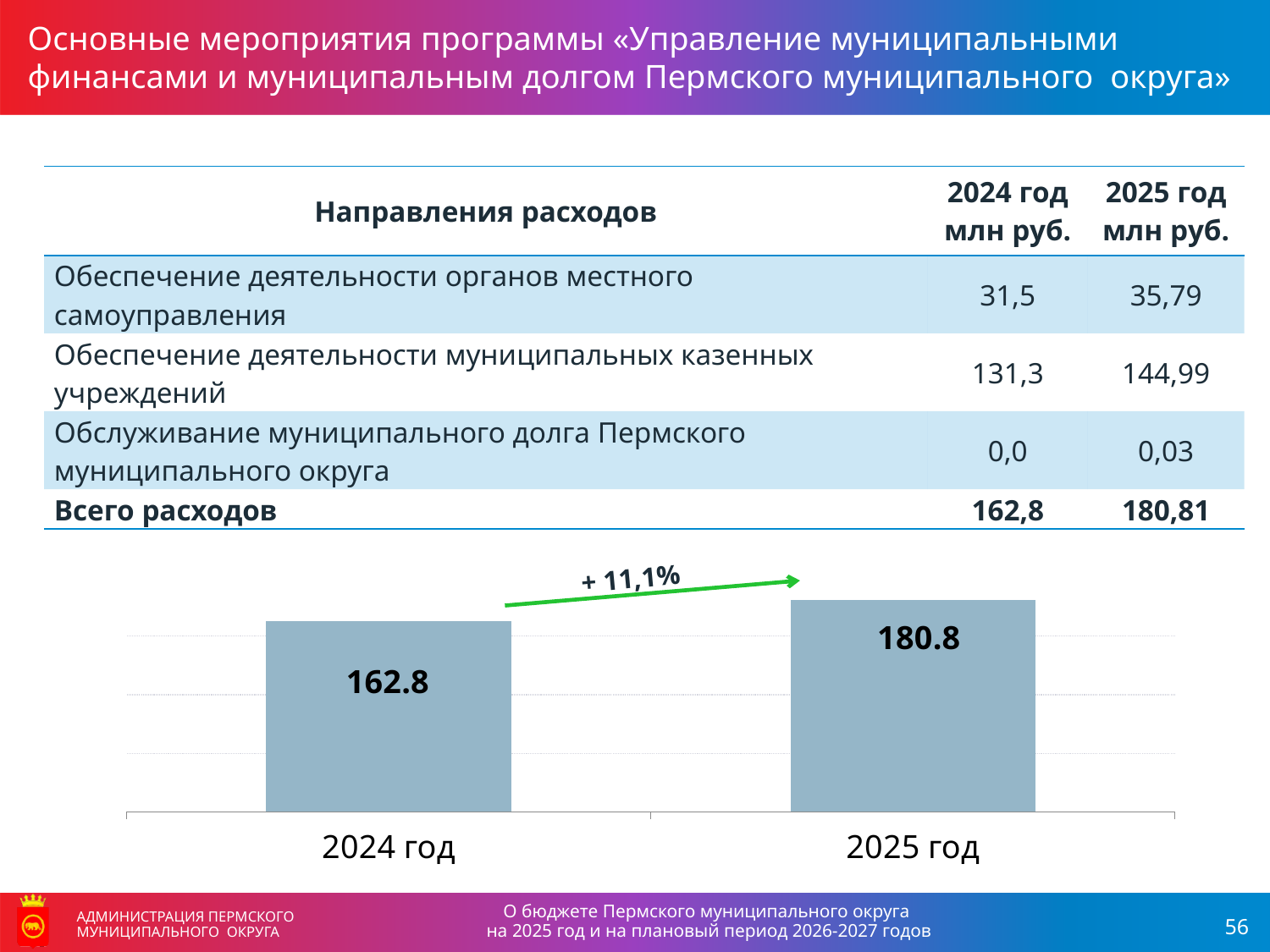
What is the value shown for 2025 год in the bar chart? 180.8 Which year has the lower bar in the chart? 2024 год By how much does the value for 2025 год exceed the value for 2024 год in the chart? 18.0 How many bars are plotted in the chart? 2 Which year has the higher bar in the chart? 2025 год What type of chart is shown on the slide? bar chart What are the two category labels on the x axis of the chart? 2024 год, 2025 год Is the bar for 2025 год larger or smaller than the bar for 2024 год? larger What is the value shown for 2024 год in the bar chart? 162.8 Do the values in the chart rise or fall from 2024 год to 2025 год? rise What percentage change is annotated on the arrow between the two bars? + 11,1%